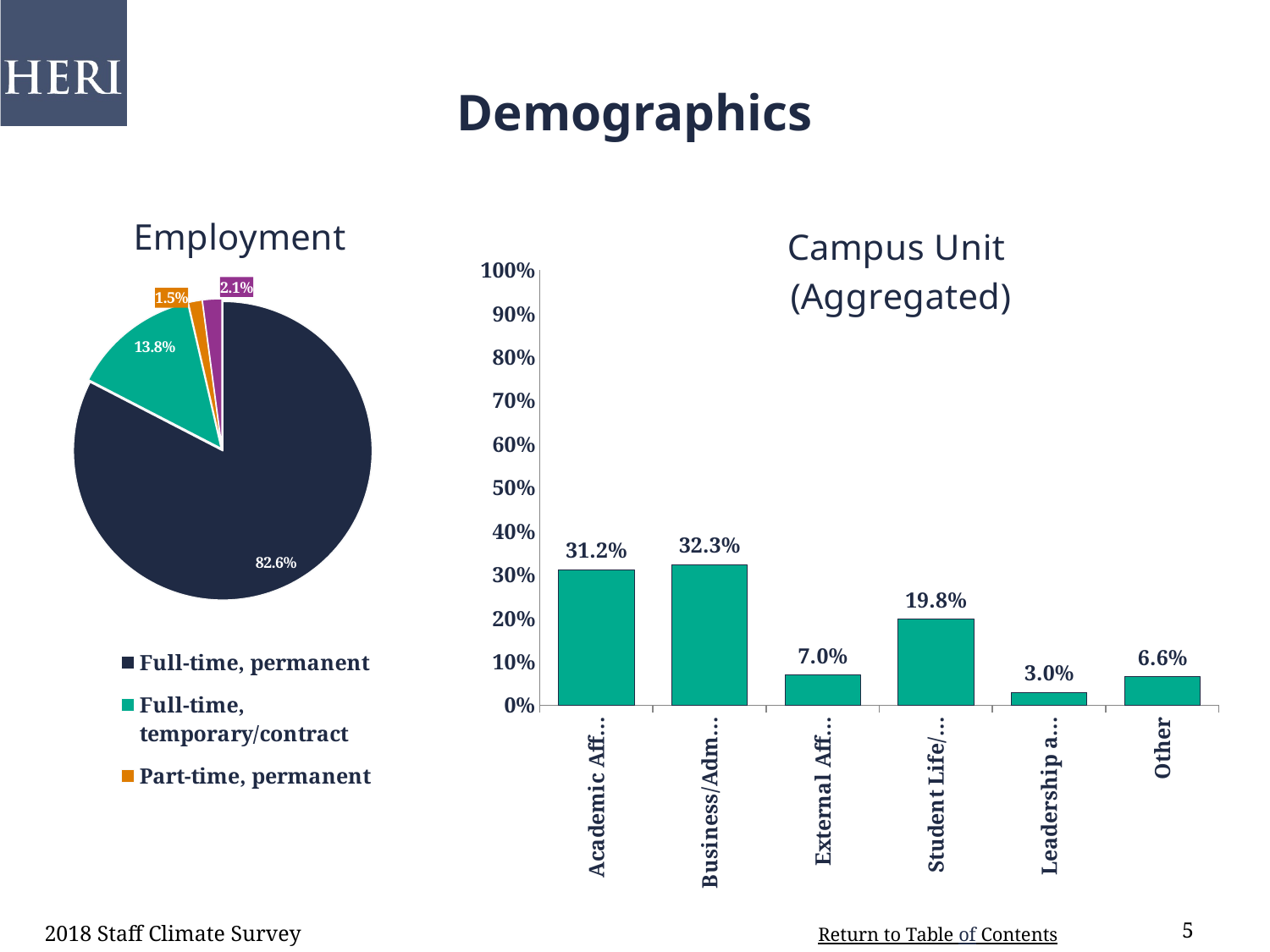
In the Employment chart, what share is Full-time, permanent? 82.6% In the Employment chart, what share is Full-time, temporary/contract? 13.8% In the Campus Unit (Aggregated) chart, what is the value for the Student Life bar? 19.8% How many entries does the legend of the Employment chart list? 3 In the Campus Unit (Aggregated) chart, which category has the lowest value? Leadership a... In the Employment chart, which category has the largest slice? Full-time, permanent In the Campus Unit (Aggregated) chart, which is larger: External Aff... or Other? External Aff... What kind of chart is the Employment chart? Pie chart In the Campus Unit (Aggregated) chart, what is the value for Other? 6.6% How many bars are in the Campus Unit (Aggregated) chart? 6 In the Campus Unit (Aggregated) chart, what is the difference between the Business/Adm... bar and the Academic Aff... bar? 1.1% In the Employment chart, what share is Part-time, permanent? 1.5%